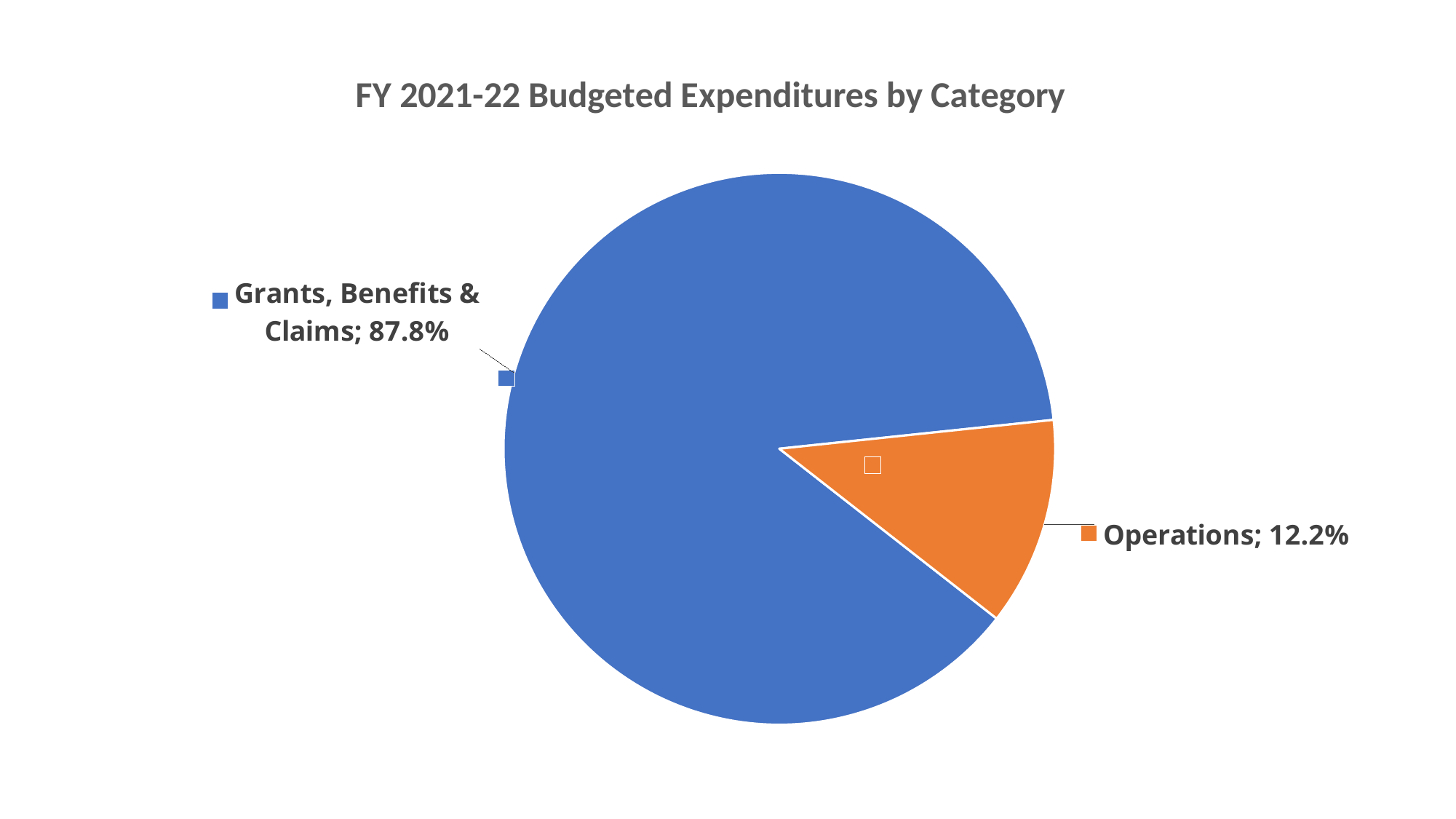
Which is larger, the share for Operations or the share for Grants, Benefits & Claims? Grants, Benefits & Claims What is the title of the chart? FY 2021-22 Budgeted Expenditures by Category How many categories are shown in the pie chart? 2 What is the difference in percentage points between Grants, Benefits & Claims and Operations? 75.6 Which category has the smallest share of the pie? Operations What share of budgeted expenditures is Grants, Benefits & Claims? 87.8% What share of budgeted expenditures is Operations? 12.2% Which category has the largest share of the pie? Grants, Benefits & Claims What colour is the Operations slice? Orange What kind of chart is shown on the slide? Pie chart